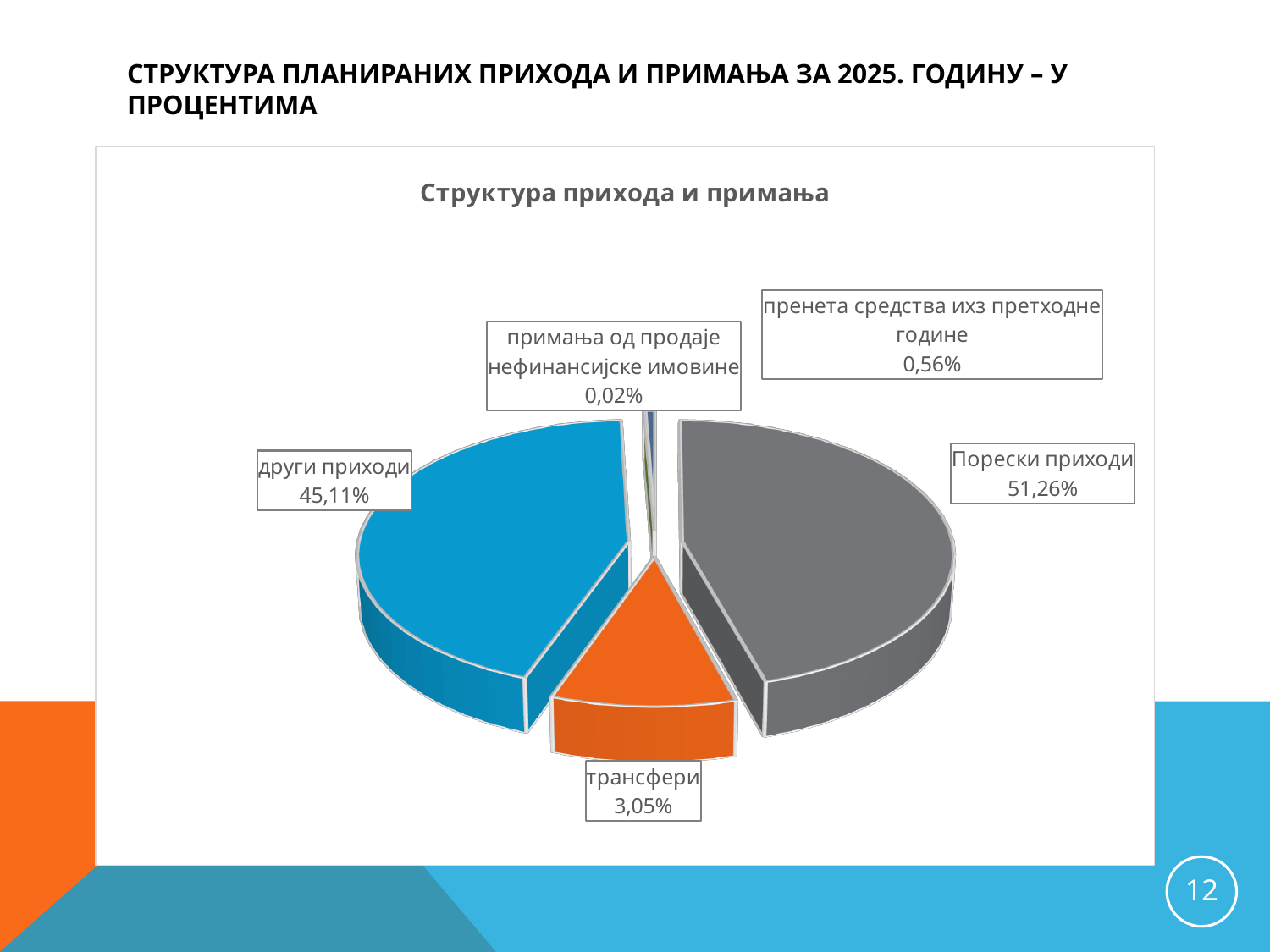
What is the difference between the shares of Порески приходи and други приходи? 6,15% What is the value shown for трансфери? 3,05% How many slices does the pie chart have? 5 What is the title of the chart? Структура прихода и примања What share of the pie does други приходи have? 45,11% Which is larger, the share for трансфери or the share for пренета средства ихз претходне године? трансфери What share of the pie does Порески приходи have? 51,26% What is the value shown for примања од продаје нефинансијске имовине? 0,02% Which category has the smallest share of the pie? примања од продаје нефинансијске имовине What is the value shown for пренета средства ихз претходне године? 0,56% What kind of chart is shown on the slide? Pie chart Which category has the largest share of the pie? Порески приходи